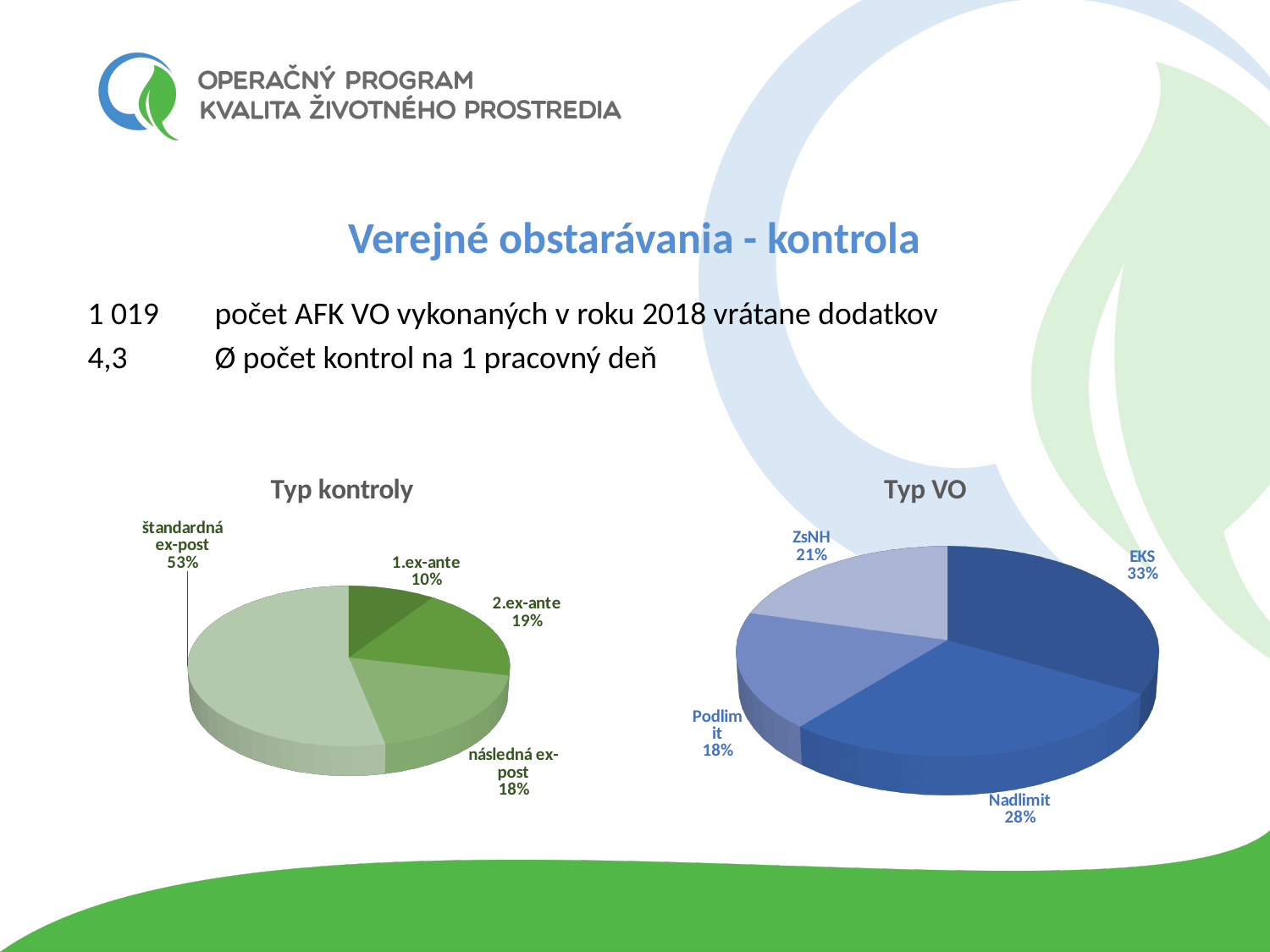
In the 'Typ VO' chart, what is the difference in percentage points between 'EKS' and 'Podlimit'? 15 In the 'Typ kontroly' chart, what is the difference in percentage points between '2.ex-ante' and 'následná ex-post'? 1 In the 'Typ VO' chart, what share does 'EKS' have? 33% In the 'Typ VO' chart, what share does 'Nadlimit' have? 28% In the 'Typ VO' chart, which category has the smallest slice? Podlimit In the 'Typ kontroly' chart, what share does 'štandardná ex-post' have? 53% In the 'Typ kontroly' chart, how many slices are there? 4 In the 'Typ kontroly' chart, which category has the largest slice? štandardná ex-post In the 'Typ kontroly' chart, which category has the smallest slice? 1.ex-ante In the 'Typ VO' chart, which is larger, 'ZsNH' or 'Nadlimit'? Nadlimit What type of chart is the 'Typ VO' chart? Pie chart